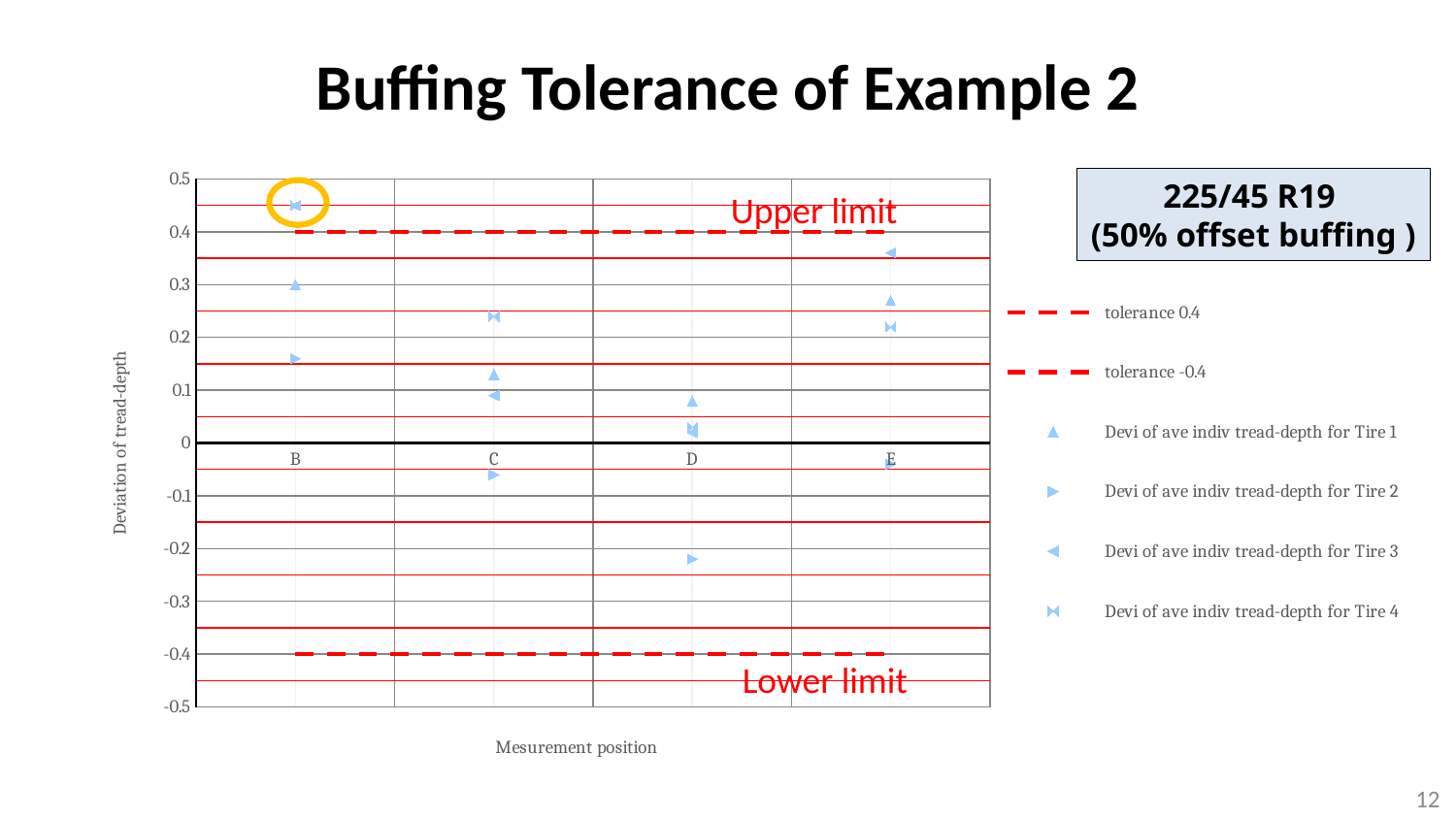
Which is larger: the value for Tire 1 at position B or at position D? position B At which measurement position is the value for Tire 4 highest? B At which measurement position is the value for Tire 2 lowest? D Is the value for Tire 4 at position B greater or less than 0.4? greater How many series does the legend list? 6 How many measurement positions are shown on the x axis? 4 Is the value for Tire 2 at position D greater or less than 0? less What kind of chart is shown on the slide? line chart What value does the upper tolerance line (Upper limit) sit at? 0.4 What value does the lower tolerance line (Lower limit) sit at? -0.4 Is the value for Tire 3 at position E greater or less than 0.3? greater